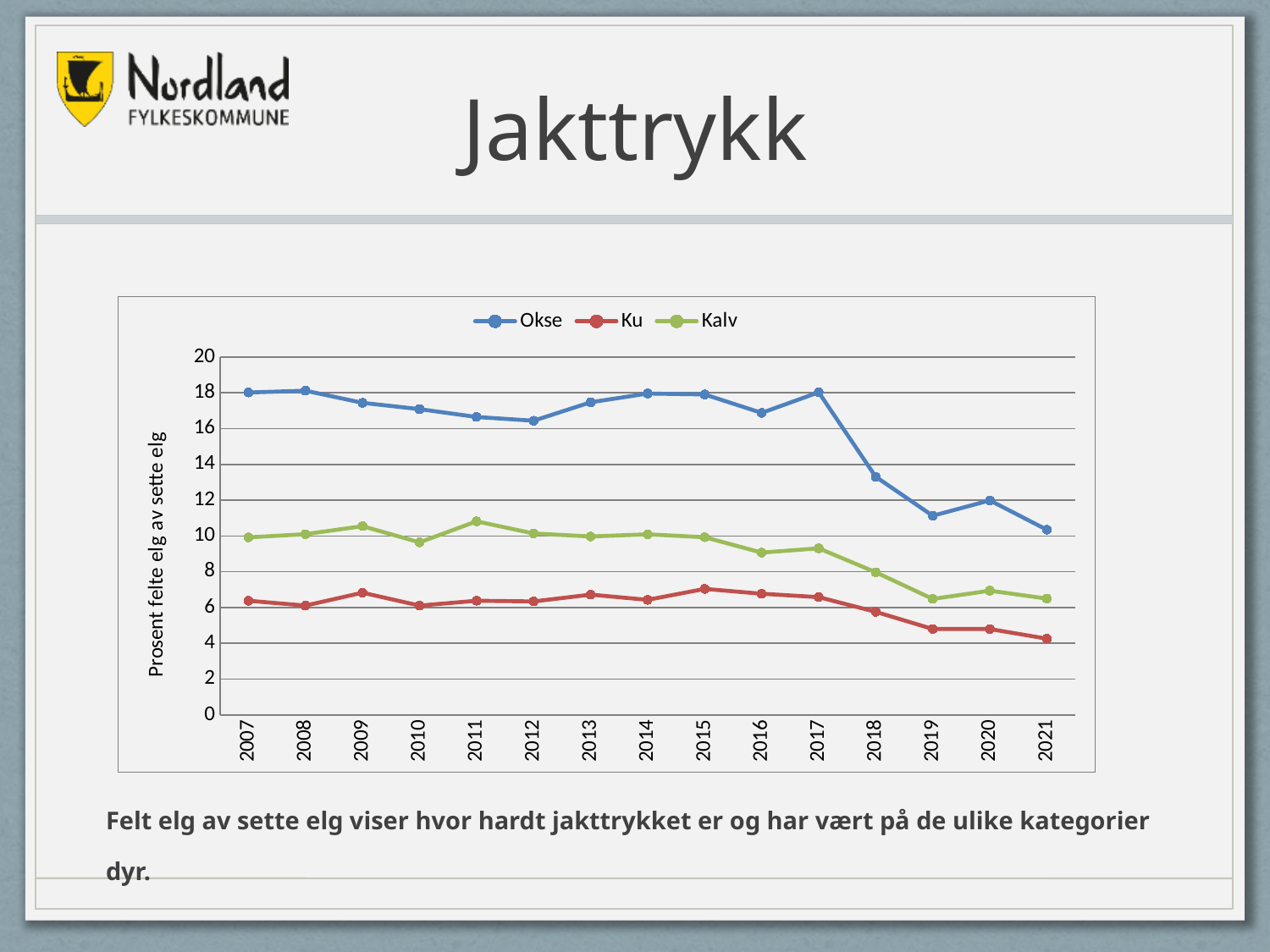
How many series does the legend list? 3 Does the Okse line rise or fall overall from 2007 to 2021? fall How many years are shown on the x axis? 15 Which series is plotted with the blue line? Okse What is the label on the y axis? Prosent felte elg av sette elg In which year is the value for Ku lowest? 2021 What kind of chart is shown on the slide? line chart Is the value for Ku in 2019 greater or less than 6? less In which year is the value for Okse lowest? 2021 Which series has the larger value in 2021, Okse or Kalv? Okse Is the value for Okse in 2018 greater or less than 12? greater Is the value for Kalv in 2011 greater or less than 10? greater